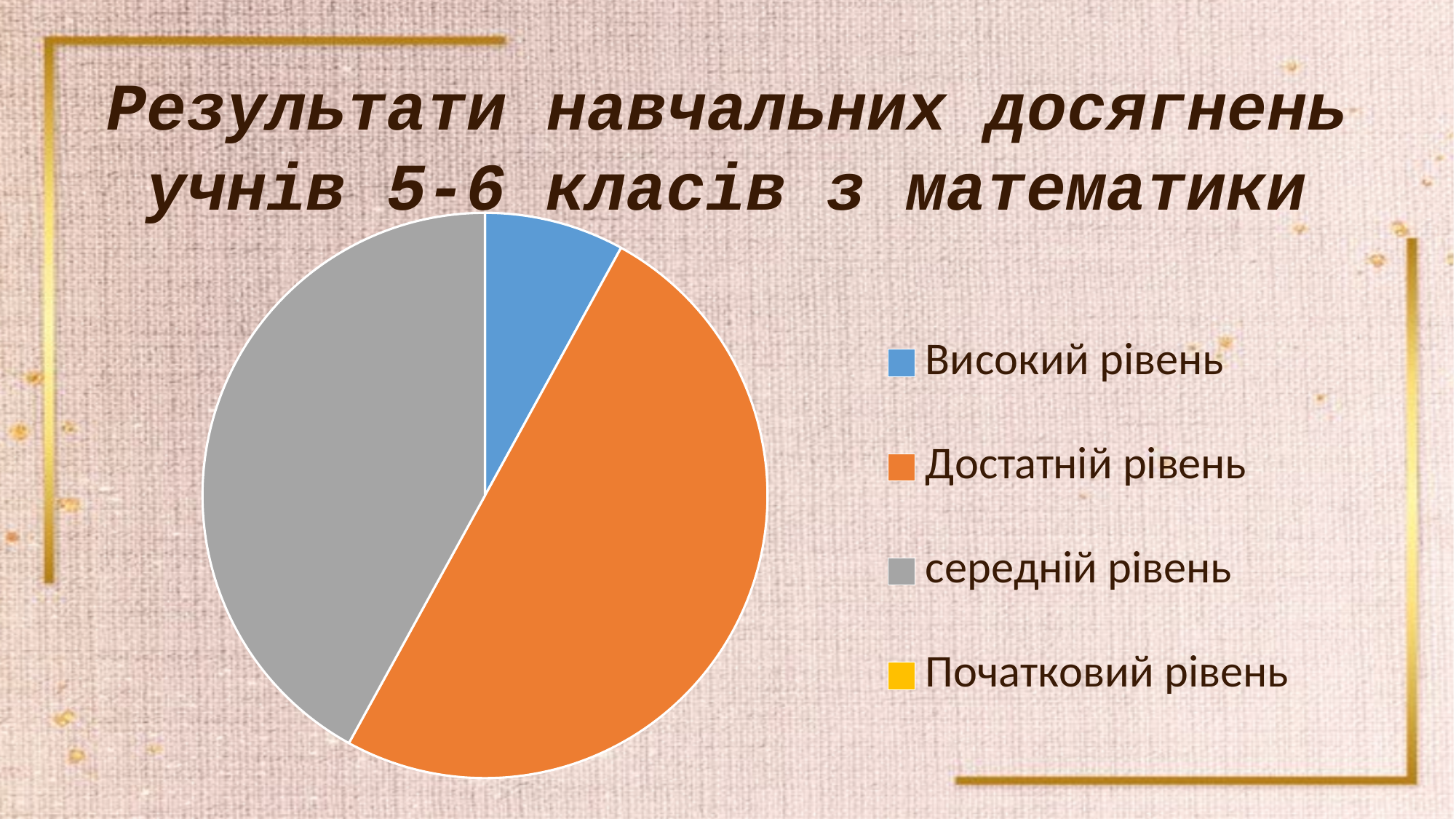
Which slice is larger, Достатній рівень or середній рівень? Достатній рівень How many categories does the legend of the pie chart list? 4 Which slice is larger, Достатній рівень or Високий рівень? Достатній рівень Which category has the largest slice of the pie chart? Достатній рівень What is the title of the slide containing the pie chart? Результати навчальних досягнень учнів 5-6 класів з математики What colour represents Високий рівень in the pie chart legend? blue What kind of chart is shown on the slide? pie chart Which slice is larger, Високий рівень or середній рівень? середній рівень